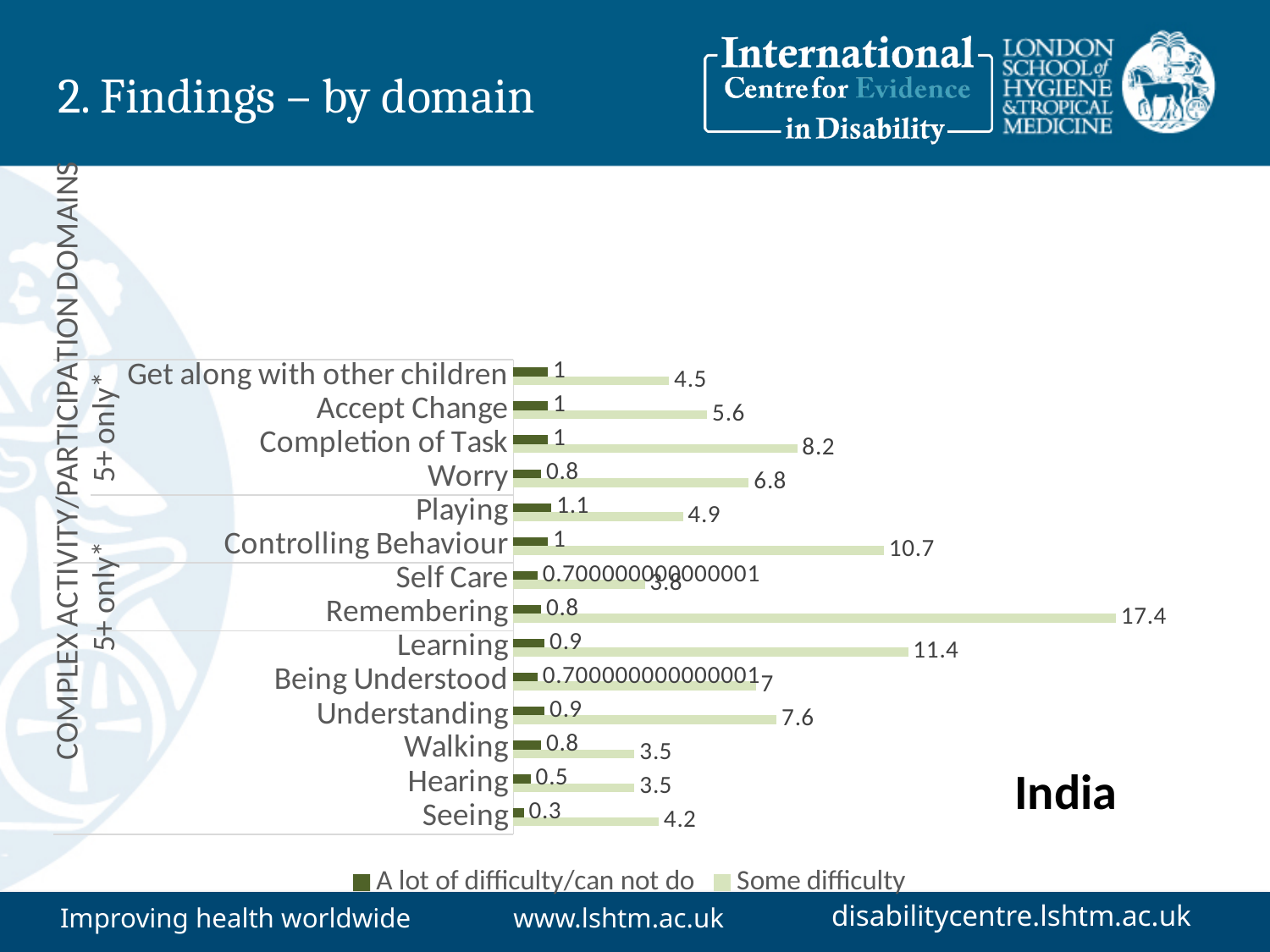
Which domain has the highest 'Some difficulty' value? Remembering What is the 'A lot of difficulty/can not do' value for Seeing? 0.3 Which has a larger 'Some difficulty' value, Worry or Accept Change? Worry What is the 'Some difficulty' value for Remembering? 17.4 Which country is the chart labelled as showing data for? India What is the 'A lot of difficulty/can not do' value for Playing? 1.1 Which domain has the lowest 'A lot of difficulty/can not do' value? Seeing What is the 'Some difficulty' value for Controlling Behaviour? 10.7 How many domains are shown in the chart? 14 What kind of chart is shown on the slide? Bar chart How many series does the legend list? 2 What is the difference between the 'Some difficulty' values for Learning and Completion of Task? 3.2